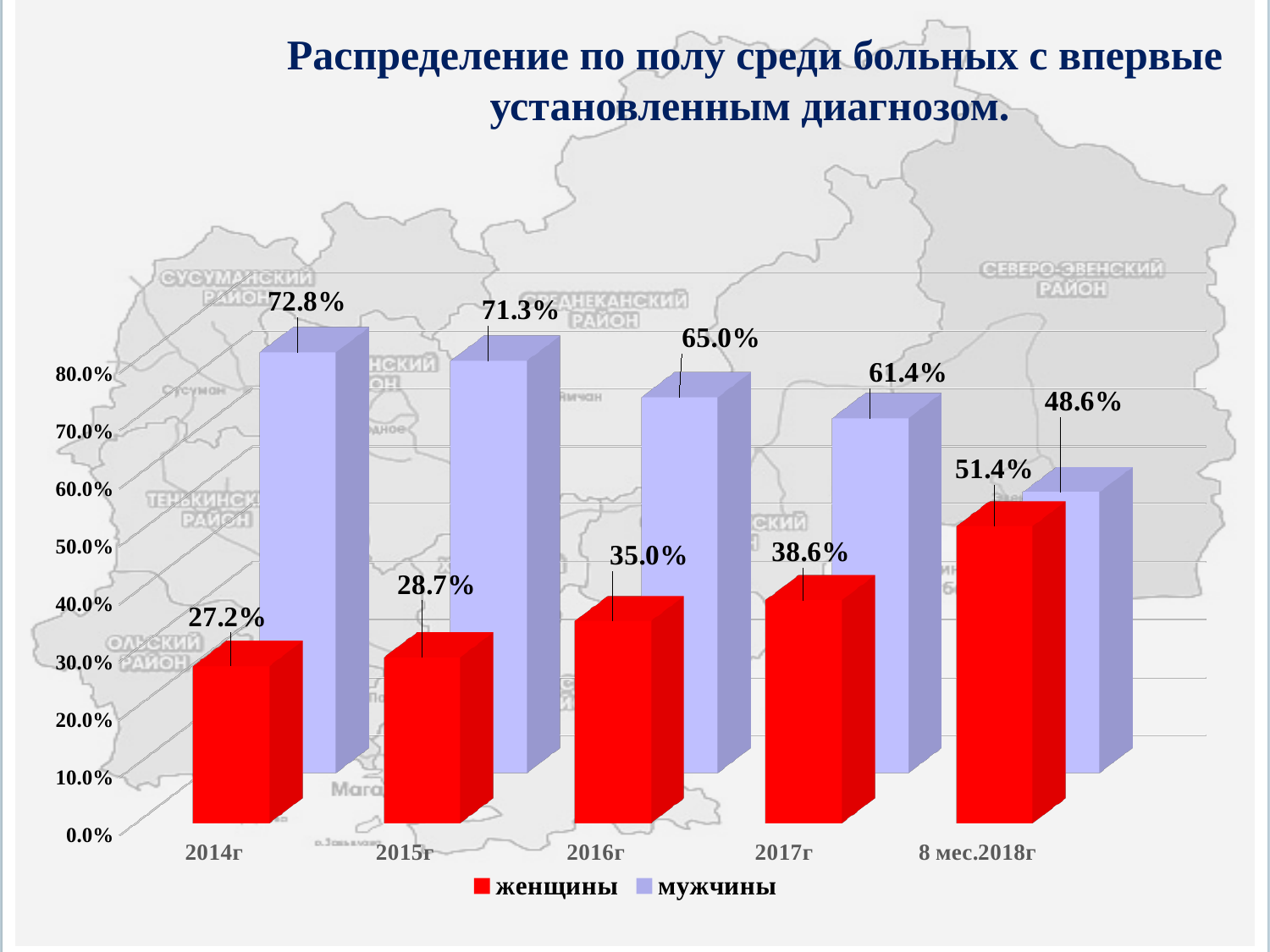
In which category is the value for женщины highest? 8 мес.2018г What is the value for мужчины in 2016г? 65.0% Which colour represents the series женщины in the legend? red How many series does the legend list? 2 Which is larger in 2015г, the value for женщины or the value for мужчины? мужчины Do the values for женщины rise or fall from 2014г to 8 мес.2018г? rise What is the value for мужчины in 8 мес.2018г? 48.6% What kind of chart is shown on the slide? bar chart What is the difference between the мужчины and женщины values in 2017г? 22.8% What is the value for женщины in 2014г? 27.2% In which category is the value for мужчины lowest? 8 мес.2018г How many categories are shown on the x axis? 5